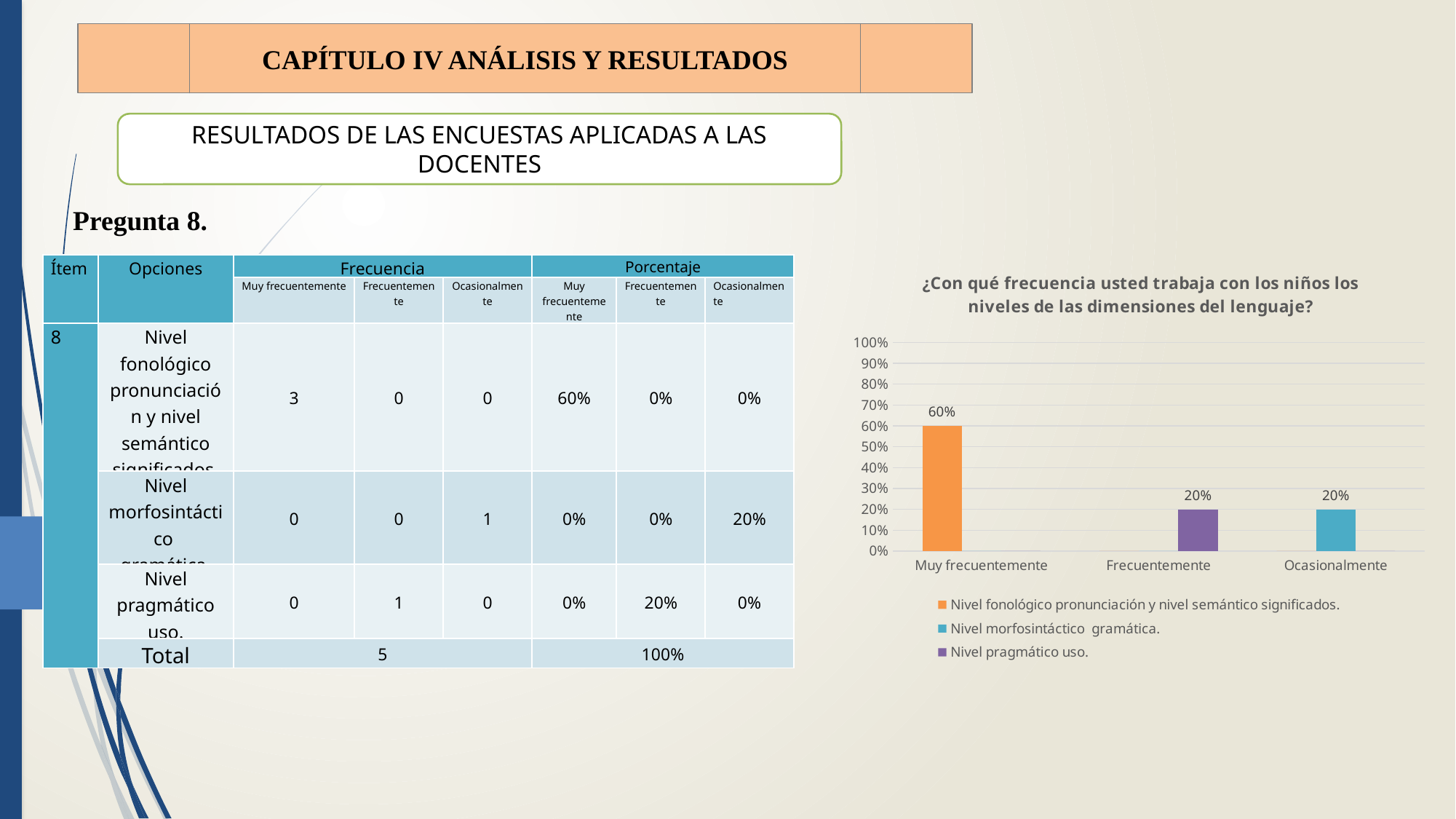
What is the difference between the bar for Muy frecuentemente and the bar for Frecuentemente? 40% How many series does the chart legend list? 3 Which category has the highest bar in the chart? Muy frecuentemente Is the value for Muy frecuentemente greater or less than 50%? greater What kind of chart is shown on the slide? bar chart Which legend entry corresponds to the orange bar? Nivel fonológico pronunciación y nivel semántico significados. What is the title of the chart? ¿Con qué frecuencia usted trabaja con los niños los niveles de las dimensiones del lenguaje? What is the value of the bar for Ocasionalmente? 20% What is the value of the bar for Muy frecuentemente? 60% How many categories are shown on the x axis of the chart? 3 Which is larger, the bar for Muy frecuentemente or the bar for Ocasionalmente? Muy frecuentemente What is the value of the bar for Frecuentemente? 20%